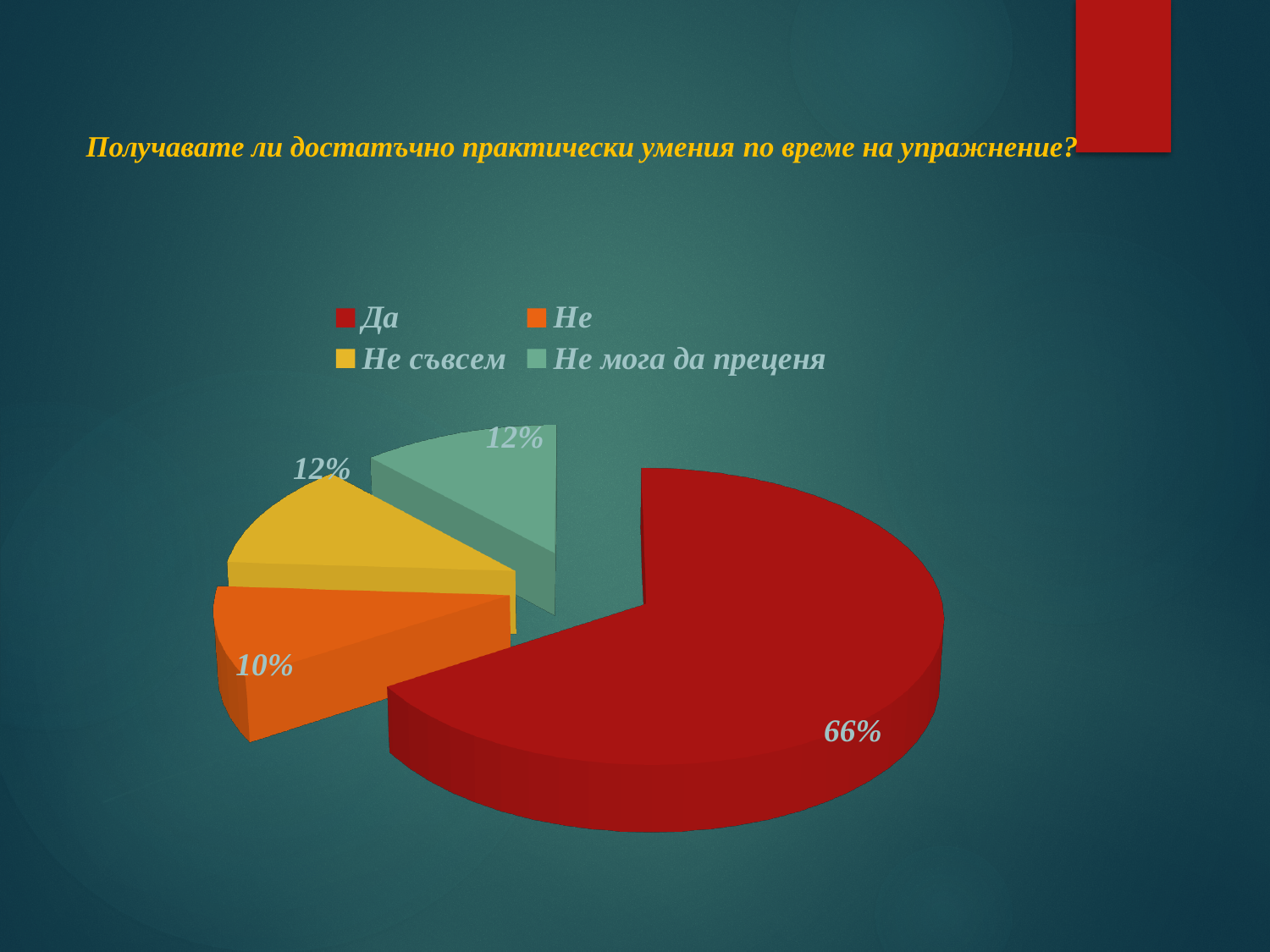
What colour is the "Да" slice of the pie? red Which is larger, the "Не съвсем" slice or the "Не" slice? Не съвсем What is the difference in percentage points between the "Да" slice and the "Не" slice? 56 How many entries does the legend list? 4 What percentage of the pie is the "Не" slice? 10% What percentage of the pie is the "Да" slice? 66% How many slices does the pie chart have? 4 What percentage of the pie is the "Не мога да преценя" slice? 12% What percentage of the pie is the "Не съвсем" slice? 12% Which category has the smallest slice of the pie? Не Which category has the largest slice of the pie? Да What kind of chart is shown on the slide? pie chart